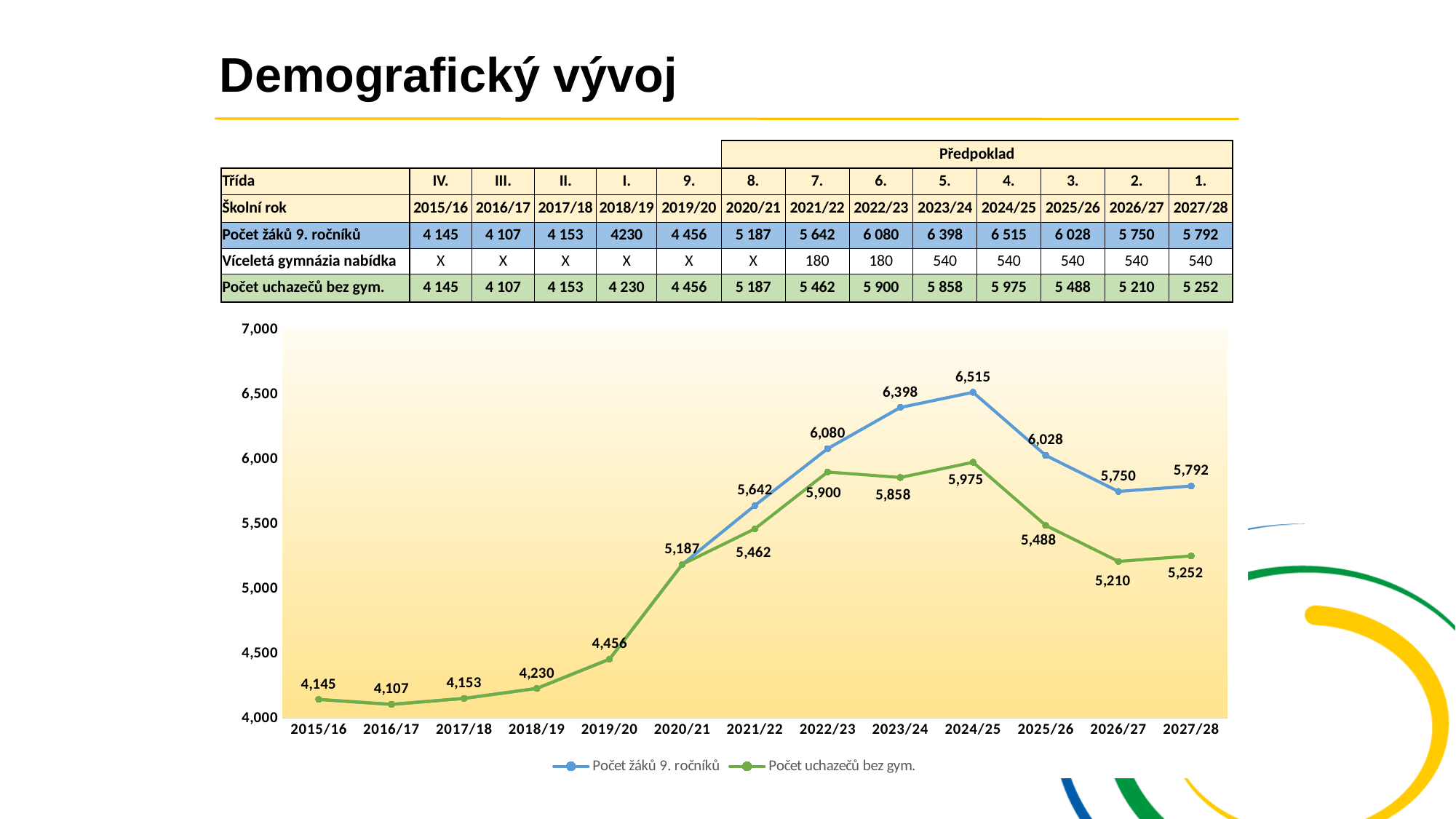
Which colour is used for the Počet uchazečů bez gym. line in the chart? green How many series does the chart legend list? 2 What is the value of Počet žáků 9. ročníků for 2024/25 in the chart? 6,515 What kind of chart is shown on the slide? line chart In which school year is the plotted value lowest? 2016/17 Which is larger in 2025/26: Počet žáků 9. ročníků or Počet uchazečů bez gym.? Počet žáků 9. ročníků In which school year does Počet žáků 9. ročníků reach its highest value? 2024/25 Does Počet žáků 9. ročníků rise or fall between 2019/20 and 2024/25? rise What is the difference between Počet žáků 9. ročníků and Počet uchazečů bez gym. in 2024/25? 540 Is the value of Počet uchazečů bez gym. for 2022/23 greater or less than 6,000? less How many school years are plotted along the x axis of the chart? 13 What is the value of Počet uchazečů bez gym. for 2026/27 in the chart? 5,210